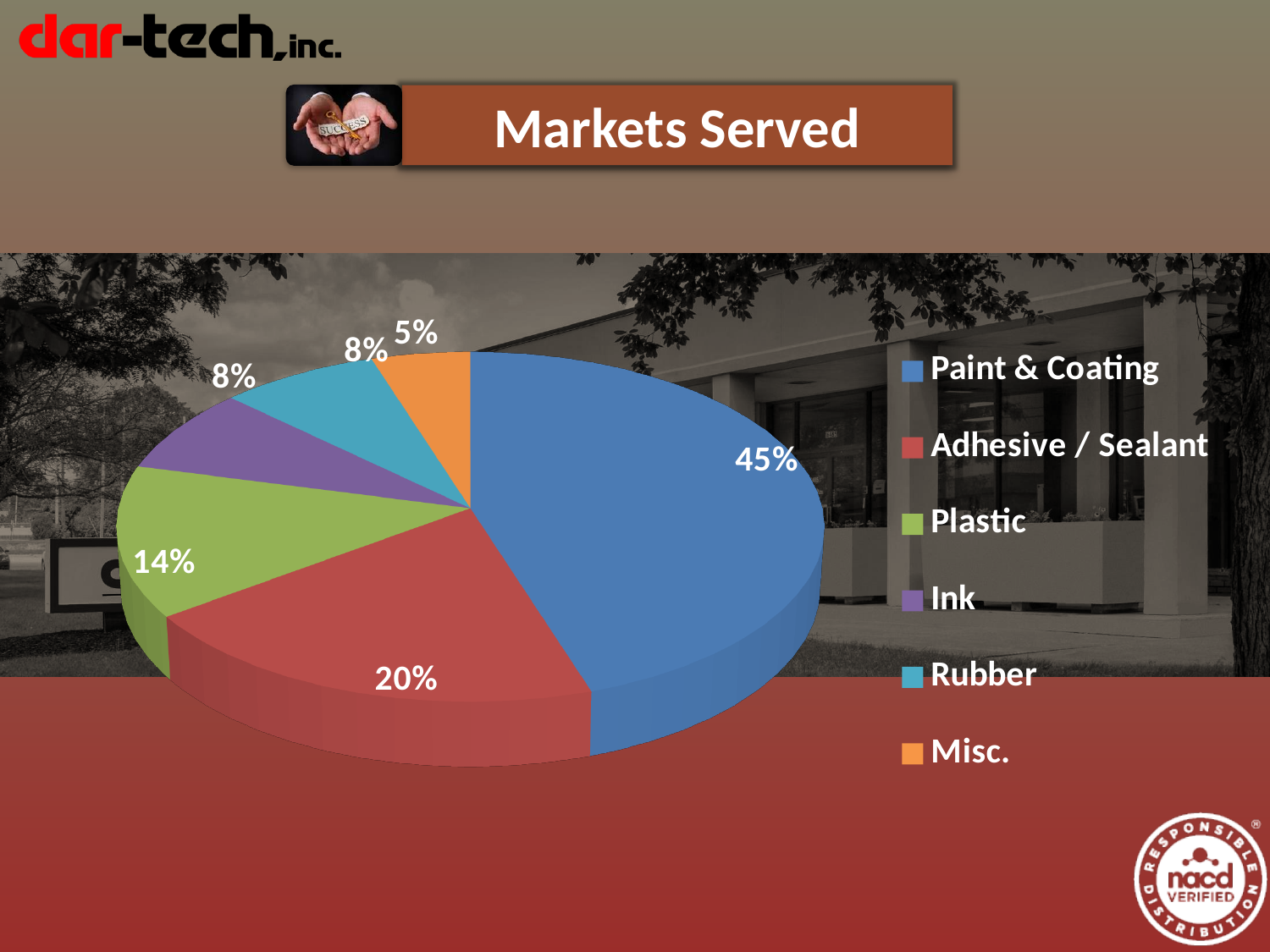
How many slices does the pie chart have? 6 What share of the pie does Paint & Coating hold? 45% What percentage is shown for Adhesive / Sealant? 20% Which market has the largest slice of the pie? Paint & Coating What percentage is shown for Misc.? 5% Which is larger, the Plastic slice or the Ink slice? Plastic What is the value for Plastic? 14% What type of chart is shown on the slide? Pie chart How many entries does the legend list? 6 What is the difference in percentage points between Paint & Coating and Adhesive / Sealant? 25 Which market has the smallest slice of the pie? Misc. What is the title of the chart? Markets Served